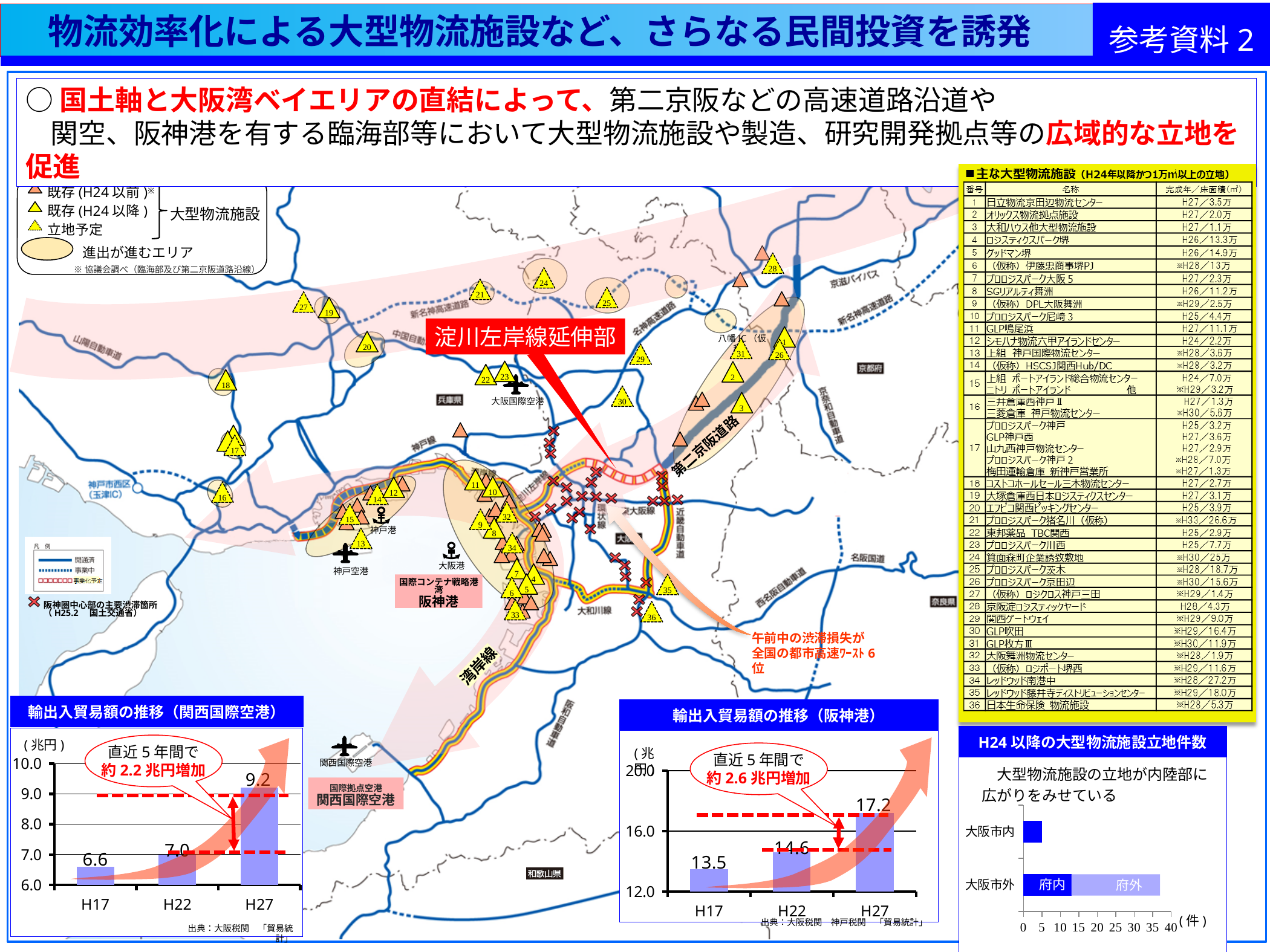
In the chart titled 輸出入貿易額の推移（阪神港）, how many years are plotted? 3 In the chart titled 輸出入貿易額の推移（関西国際空港）, which year has the lowest value? H17 What kind of chart is the chart titled 輸出入貿易額の推移（阪神港）? bar chart In the chart titled 輸出入貿易額の推移（関西国際空港）, do the values rise or fall from H17 to H27? rise In the chart titled H24以降の大型物流施設立地件数, is the value for 大阪市内 greater or less than 10? less In the chart titled 輸出入貿易額の推移（阪神港）, what is the value for H22? 14.6 In the chart titled 輸出入貿易額の推移（関西国際空港）, what is the difference between the H27 and H22 values? 2.2 In the chart titled 輸出入貿易額の推移（関西国際空港）, what is the value for H27? 9.2 In the chart titled H24以降の大型物流施設立地件数, which category has the larger bar, 大阪市内 or 大阪市外? 大阪市外 In the chart titled 輸出入貿易額の推移（阪神港）, what is the difference between the H27 and H17 values? 3.7 In the chart titled 輸出入貿易額の推移（関西国際空港）, what is the value for H17? 6.6 In the chart titled 輸出入貿易額の推移（阪神港）, which year has the highest value? H27